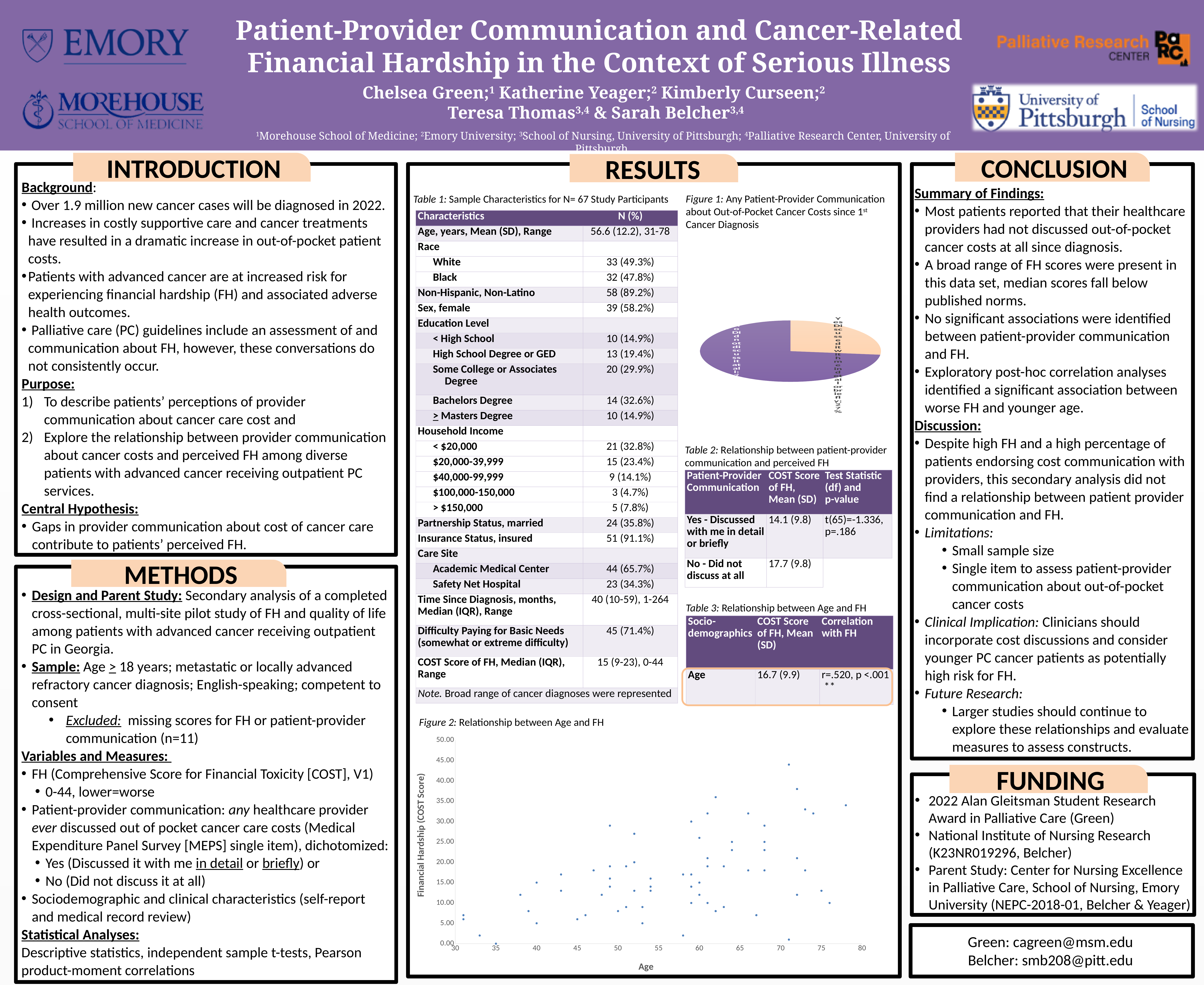
In Figure 2, is the lowest plotted Financial Hardship (COST Score) value greater or less than 5? less How many slices does the pie chart in Figure 1 have? 2 What kind of chart is Figure 1 (Any Patient-Provider Communication about Out-of-Pocket Cancer Costs)? pie chart What is the lowest tick value shown on the x axis of Figure 2? 30 What is the title of Figure 2? Relationship between Age and FH In Figure 2, is the highest plotted Financial Hardship (COST Score) value greater or less than 40? greater What is the label of the y axis in Figure 2? Financial Hardship (COST Score) In the Figure 1 pie chart, which slice is larger, the purple one or the peach one? the purple one In Figure 2, do Financial Hardship (COST Score) values tend to rise or fall as Age increases? rise What kind of chart is Figure 2 (Relationship between Age and FH)? scatter plot